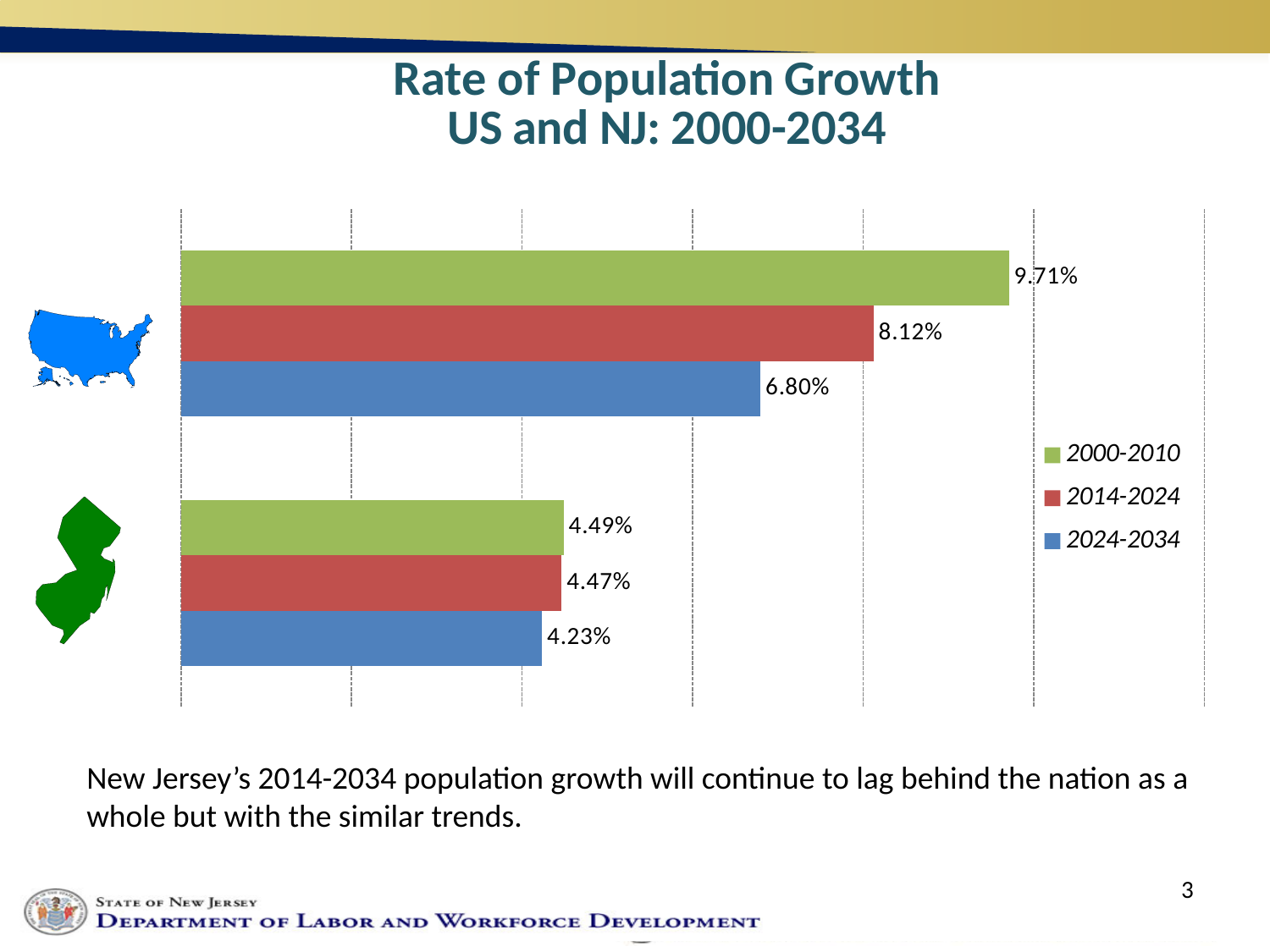
Which period has the lowest population growth rate for NJ (bottom group of bars)? 2024-2034 What is the US population growth rate for 2024-2034 (top group of bars)? 6.80% Which period has the highest population growth rate for the US (top group of bars)? 2000-2010 What is the NJ population growth rate for 2014-2024 (bottom group of bars)? 4.47% What is the NJ population growth rate for 2024-2034 (bottom group of bars)? 4.23% What is the US population growth rate for 2000-2010 (top group of bars)? 9.71% What is the difference between the US and NJ population growth rates for 2000-2010? 5.22% What is the title of the chart? Rate of Population Growth US and NJ: 2000-2034 Which is larger, the US 2024-2034 growth rate or the NJ 2000-2010 growth rate? US 2024-2034 (6.80%) What type of chart is shown on the slide? bar chart How many series does the legend list? 3 What is the difference between the US 2014-2024 and 2024-2034 growth rates? 1.32%